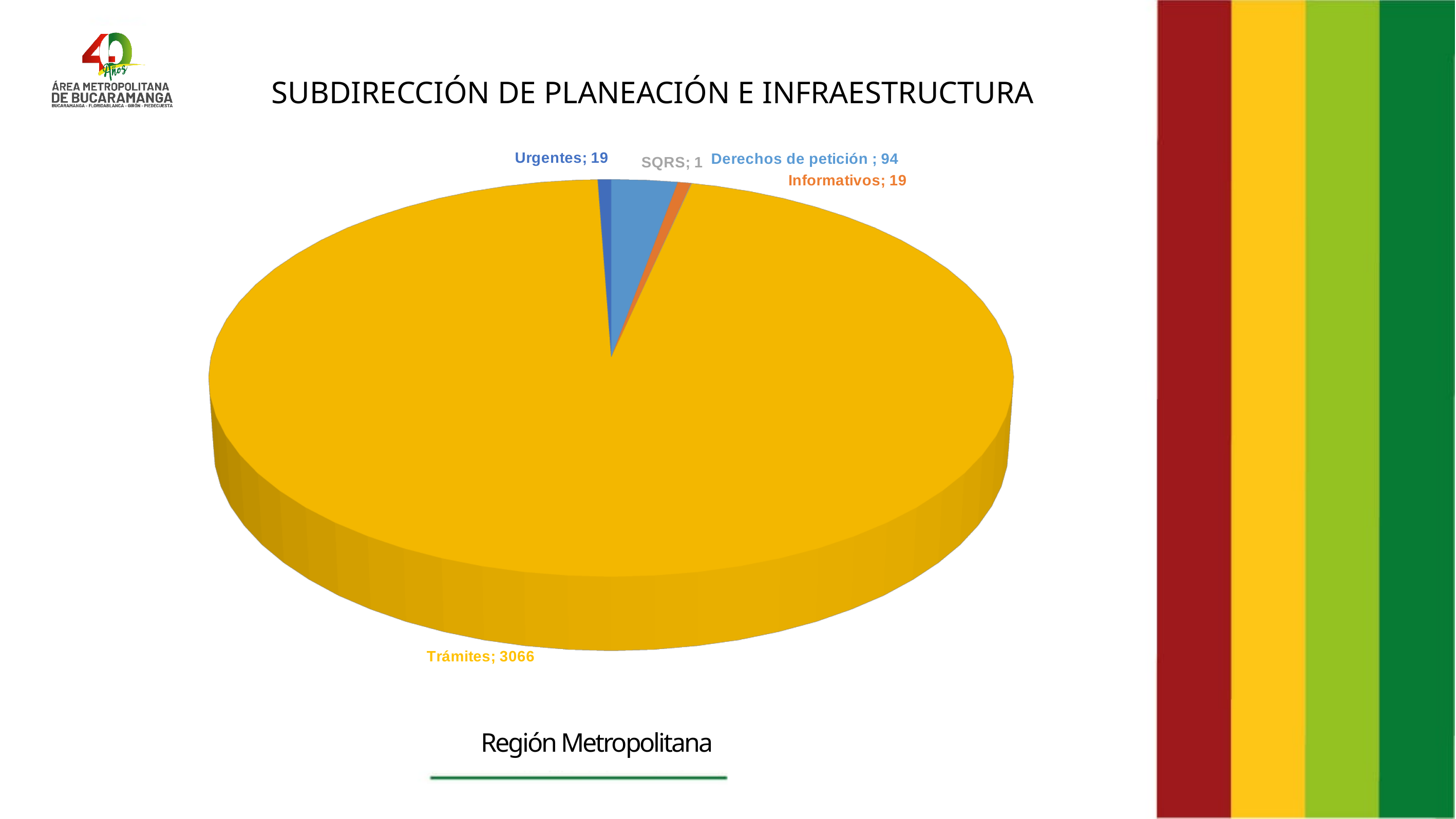
What is the difference between the values for Derechos de petición and Urgentes? 75 Which category has the smallest value? SQRS What is the total of all the values shown in the pie chart? 3199 What is the difference between the values for Trámites and Derechos de petición? 2972 What is the value for Informativos? 19 What is the value for Trámites? 3066 What is the value for SQRS? 1 What kind of chart is shown on the slide? Pie chart Which category has the largest slice of the pie? Trámites What is the value for Derechos de petición? 94 How many categories are shown in the pie chart? 5 Which is larger, the value for Derechos de petición or the value for Informativos? Derechos de petición